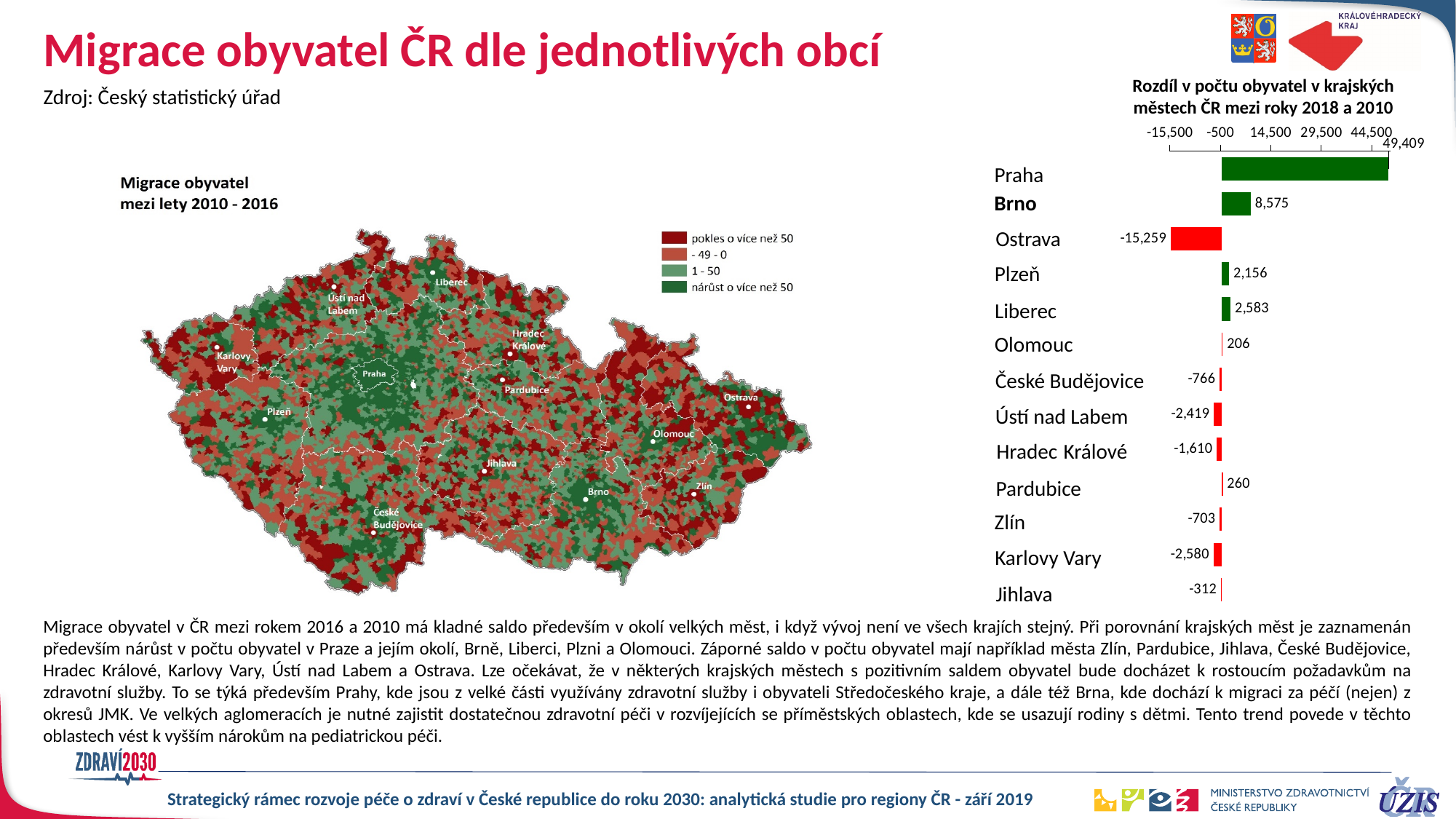
In the bar chart on the right, what is the value for Ostrava? -15,259 What kind of chart is shown on the right side of the slide? Bar chart In the bar chart on the right, which city has the highest value? Praha In the bar chart 'Rozdíl v počtu obyvatel v krajských městech ČR mezi roky 2018 a 2010', what is the value for Praha? 49,409 In the bar chart on the right, what is the difference between the values for Liberec and Plzeň? 427 In the bar chart on the right, what is the value for Karlovy Vary? -2,580 In the bar chart on the right, which city has the lowest value? Ostrava In the bar chart on the right, which is larger, the value for Pardubice or the value for Olomouc? Pardubice In the bar chart on the right, what colour are the bars with negative values? Red In the bar chart on the right, what is the value for Liberec? 2,583 In the bar chart on the right, how many cities are shown? 13 In the bar chart on the right, what is the difference between the values for Praha and Brno? 40,834